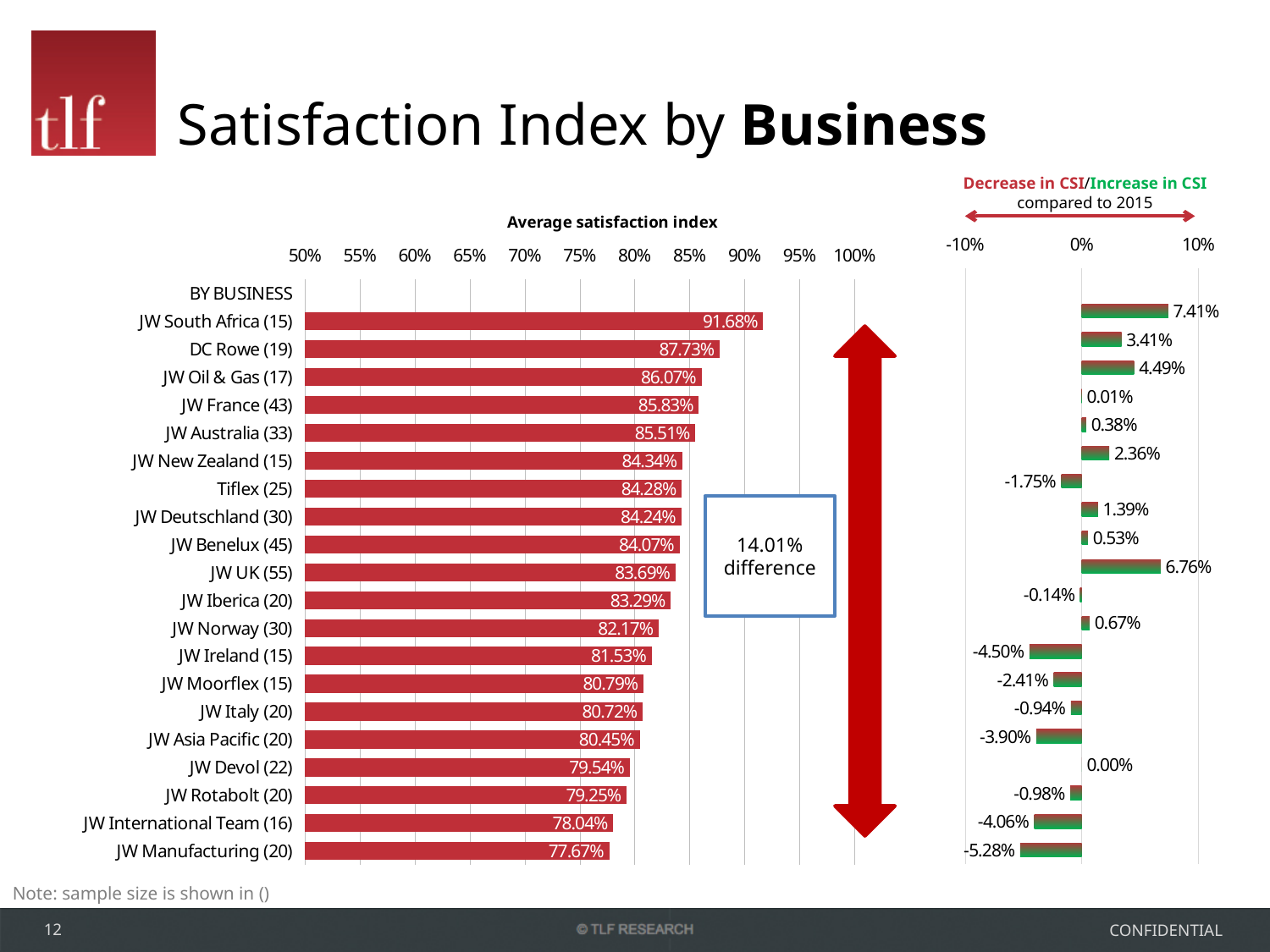
On the Average satisfaction index chart, what is the value for JW Norway (30)? 82.17% On the Decrease in CSI/Increase in CSI chart, which business has the largest increase compared to 2015? JW South Africa (15) On the Decrease in CSI/Increase in CSI chart, which is larger: the value for JW Ireland (15) or the value for JW Moorflex (15)? JW Moorflex (15) On the Average satisfaction index chart, how many businesses are plotted? 20 On the Average satisfaction index chart, what is the value for JW South Africa (15)? 91.68% On the Average satisfaction index chart, which business has the highest satisfaction index? JW South Africa (15) On the Average satisfaction index chart, which business has the lowest satisfaction index? JW Manufacturing (20) On the Decrease in CSI/Increase in CSI chart, what is the value for JW UK (55)? 6.76% On the Average satisfaction index chart, is the value for JW Devol (22) greater or less than 80%? less On the Average satisfaction index chart, what is the difference between the values for DC Rowe (19) and JW Oil & Gas (17)? 1.66% What type of chart is the Average satisfaction index chart? Bar chart On the Decrease in CSI/Increase in CSI chart, what is the value for JW Manufacturing (20)? -5.28%